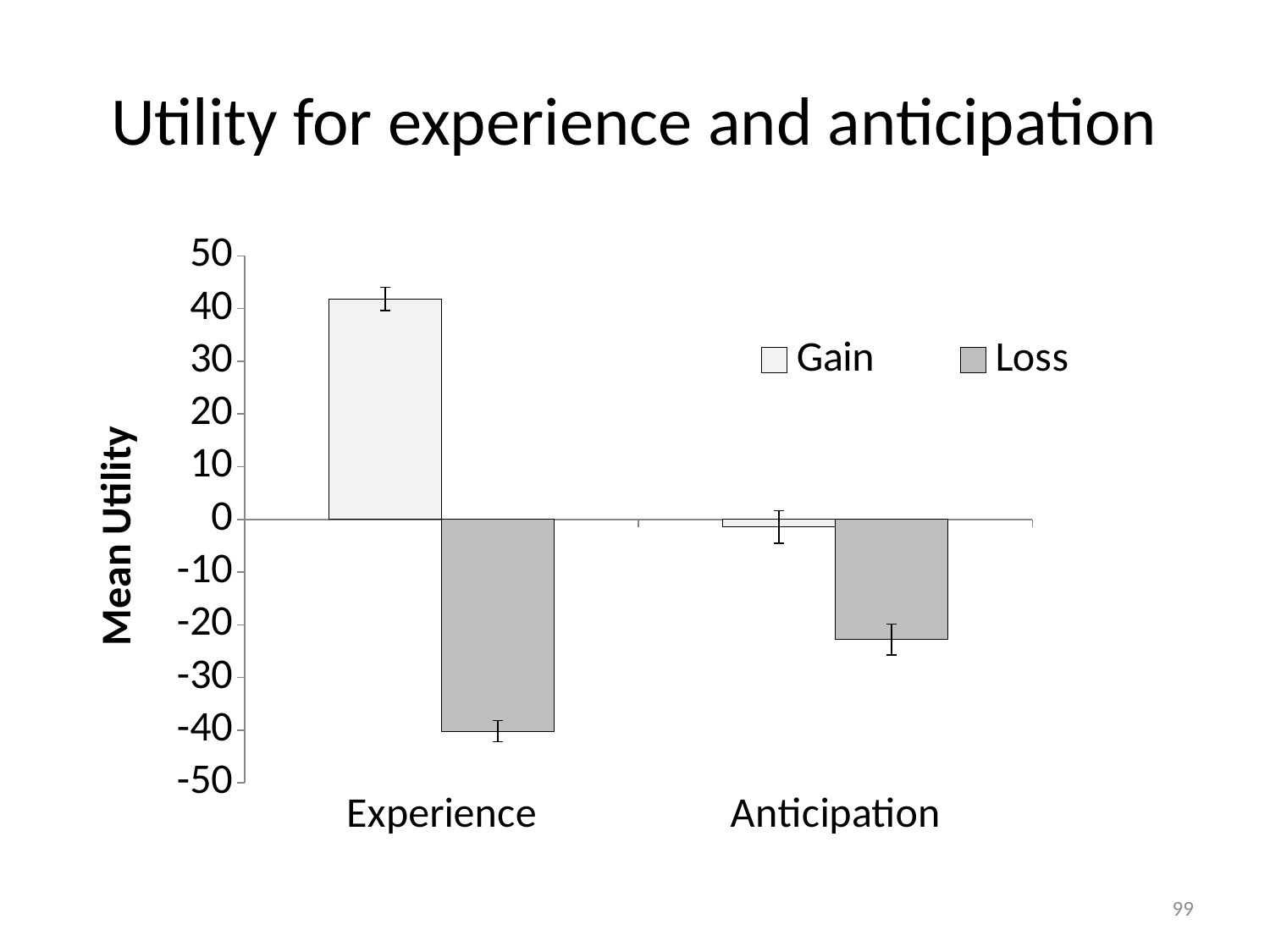
Is the Loss value for Experience greater or less than -30? less How many categories are shown on the x axis of the chart? 2 Is the Loss value for Anticipation greater or less than -10? less Is the Gain value for Experience greater or less than 30? greater Which is larger, the Gain value for Experience or the Gain value for Anticipation? Experience What kind of chart is shown on the slide? bar chart Which bar has the highest value in the chart? Gain for Experience What is the label of the vertical axis? Mean Utility How many series does the chart's legend list? 2 What is the title of the chart on the slide? Utility for experience and anticipation Which bar has the lowest value in the chart? Loss for Experience